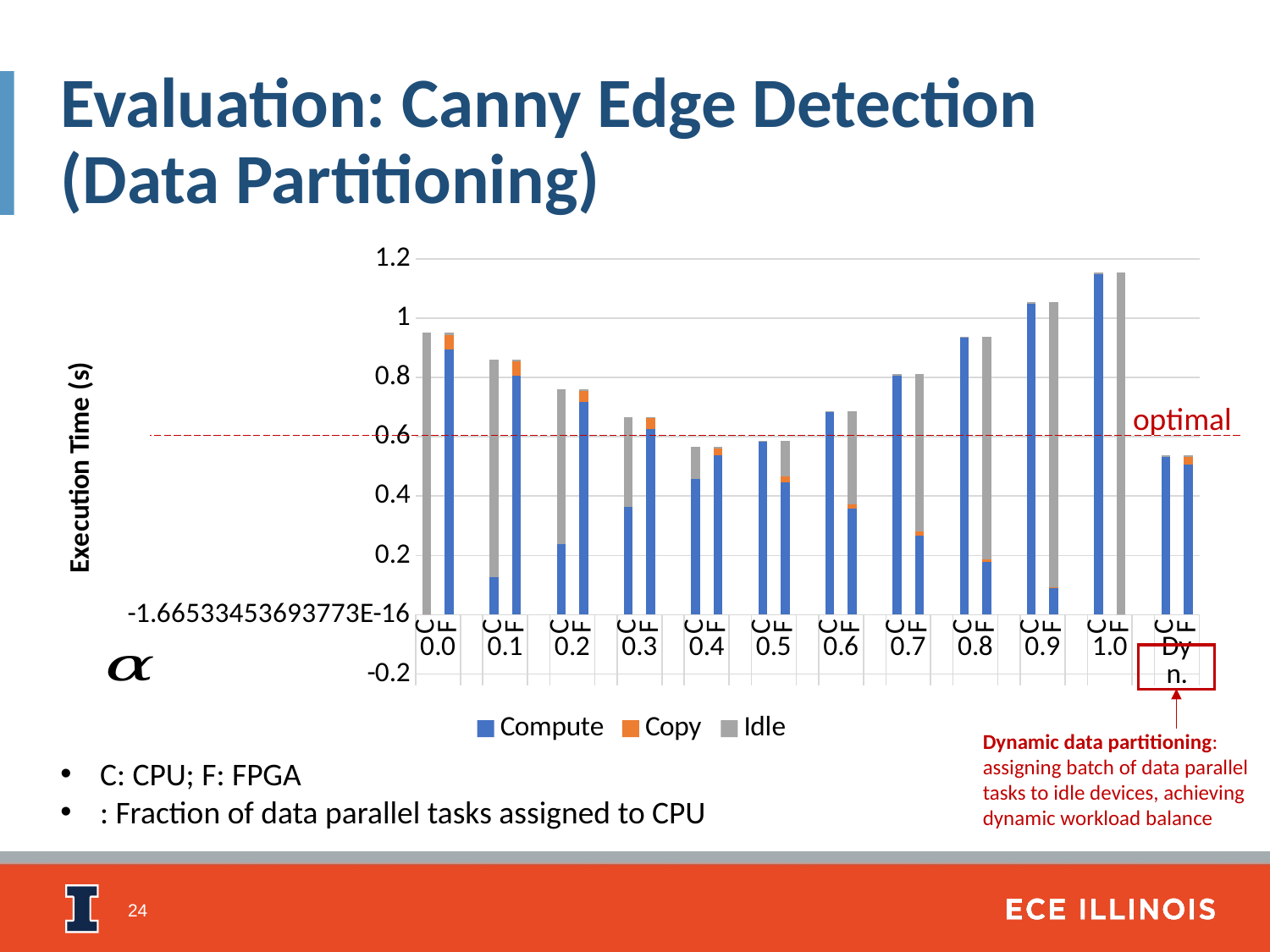
Is the total execution time of the C bar at alpha 0.0 greater or less than 0.8? greater Is the total execution time of the C bar for Dyn. greater or less than 0.6? less Which x-axis group has the lowest total execution time bars? Dyn. Which alpha value has the highest total execution time bars? 1.0 Do the total execution times rise or fall as alpha increases from 0.4 to 1.0? rise What are the three series named in the chart legend? Compute, Copy, Idle What is the label of the chart's vertical axis? Execution Time (s) What kind of chart is shown on the slide? stacked bar chart Is the total execution time of the C bar at alpha 1.0 greater or less than 1? greater Which has a larger total execution time: the bars at alpha 1.0 or the bars at Dyn.? 1.0 How many alpha values (x-axis groups) are shown on the chart, including Dyn.? 12 How many series does the chart legend list? 3